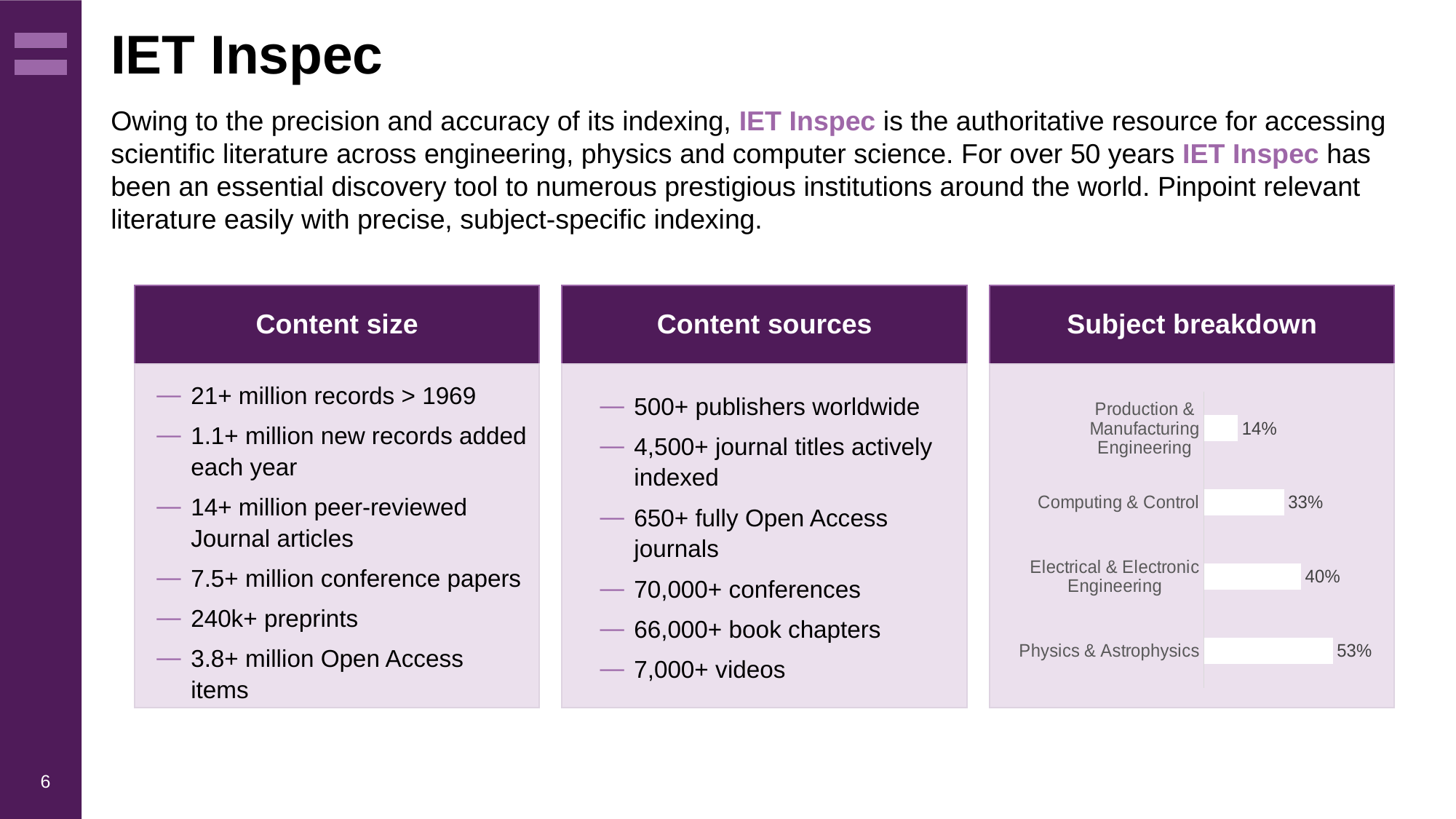
What is the difference between the values for Physics & Astrophysics and Computing & Control in the Subject breakdown chart? 20% What is the value for Production & Manufacturing Engineering in the Subject breakdown chart? 14% What is the title of the chart on the slide? Subject breakdown What is the value for Computing & Control in the Subject breakdown chart? 33% What is the value for Physics & Astrophysics in the Subject breakdown chart? 53% How many subject categories are shown in the Subject breakdown chart? 4 What is the difference between the values for Electrical & Electronic Engineering and Production & Manufacturing Engineering in the Subject breakdown chart? 26% Which subject has the highest value in the Subject breakdown chart? Physics & Astrophysics Which subject has the lowest value in the Subject breakdown chart? Production & Manufacturing Engineering What is the value for Electrical & Electronic Engineering in the Subject breakdown chart? 40% In the Subject breakdown chart, which is larger: Electrical & Electronic Engineering or Computing & Control? Electrical & Electronic Engineering What kind of chart is the Subject breakdown chart? Bar chart